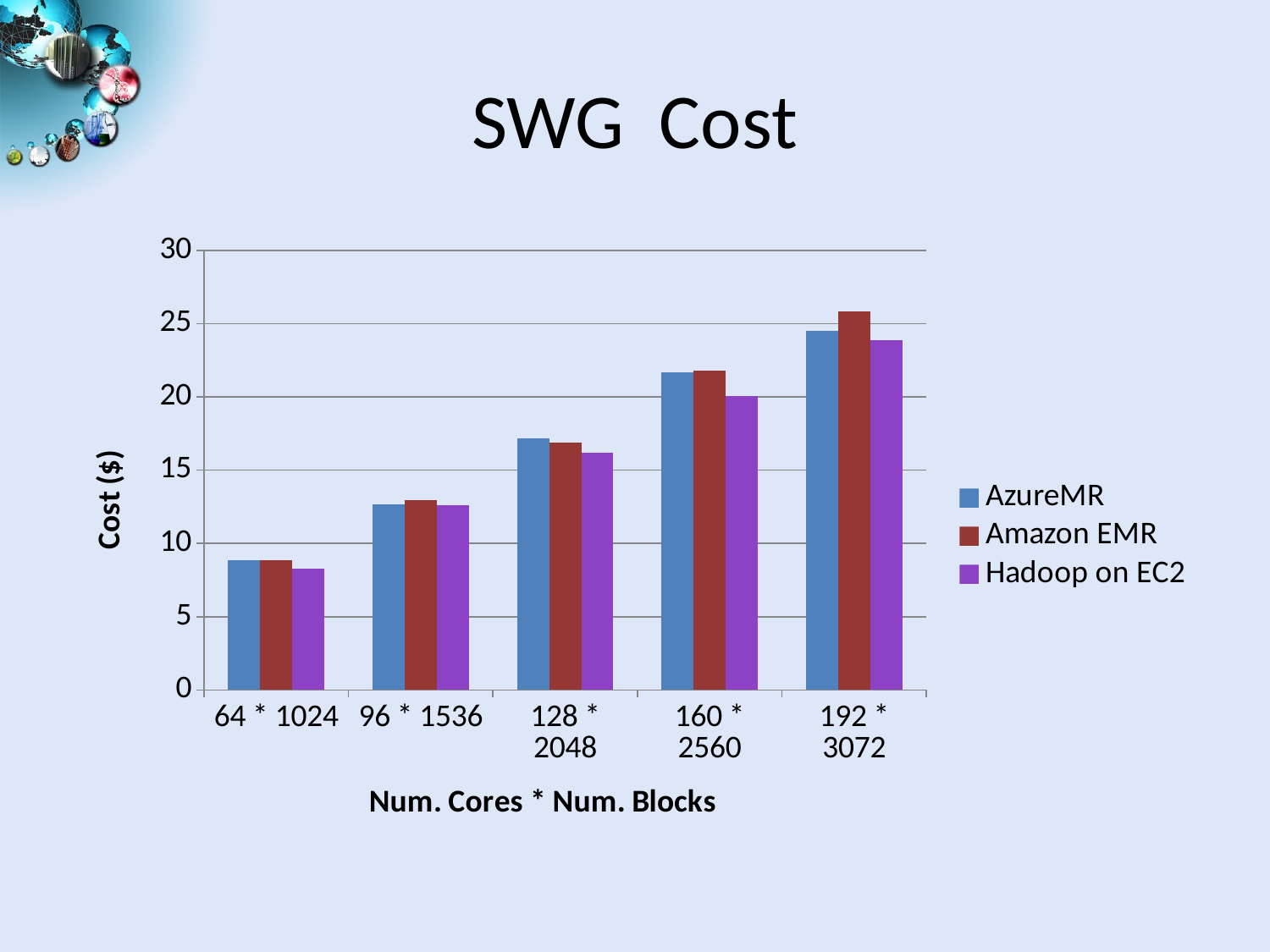
Is the Hadoop on EC2 cost for 192 * 3072 greater or less than 25? less Which series has the lowest cost for 192 * 3072? Hadoop on EC2 What is the title of the y axis? Cost ($) Is the AzureMR cost for 128 * 2048 greater or less than 15? greater Is the Amazon EMR cost for 192 * 3072 greater or less than 25? greater How many categories are shown on the x axis? 5 For 160 * 2560, which is larger: the AzureMR cost or the Hadoop on EC2 cost? AzureMR Which series has the highest cost for 192 * 3072? Amazon EMR What kind of chart is shown on the slide? bar chart How many series does the legend list? 3 Do the AzureMR costs rise or fall as Num. Cores * Num. Blocks increases along the x axis? rise